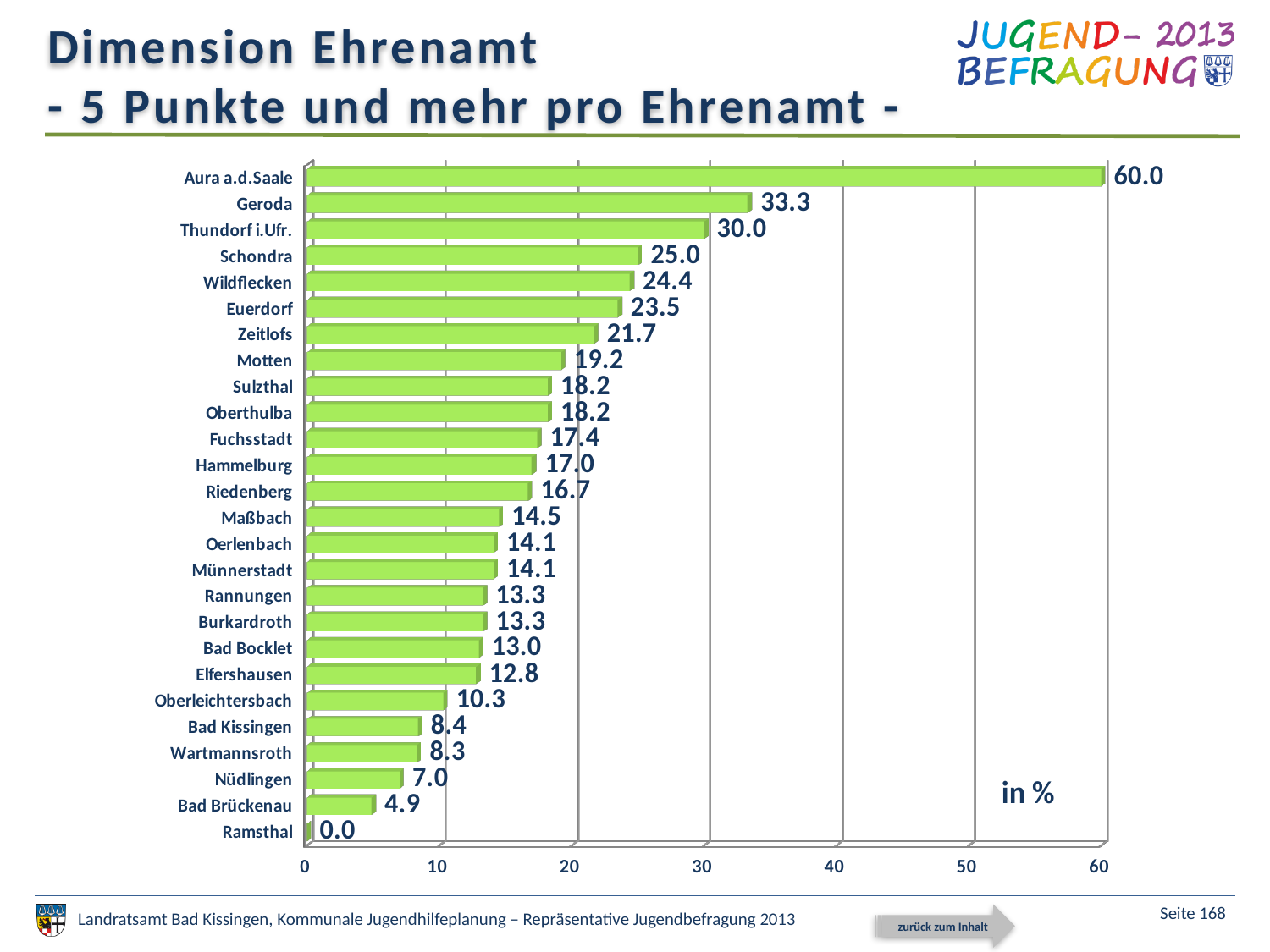
Which has a larger value, Schondra or Zeitlofs? Schondra What is the value for Bad Kissingen? 8.4 What is the value for Aura a.d.Saale? 60.0 Which category has the lowest value? Ramsthal What is the difference between the values for Geroda and Thundorf i.Ufr.? 3.3 How many categories are shown in the chart? 26 What is the difference between the values for Nüdlingen and Bad Brückenau? 2.1 Is the value for Oberleichtersbach greater or less than 20? less What kind of chart is shown on the slide? bar chart What is the value for Hammelburg? 17.0 What unit is indicated on the chart? in % Which category has the highest value? Aura a.d.Saale